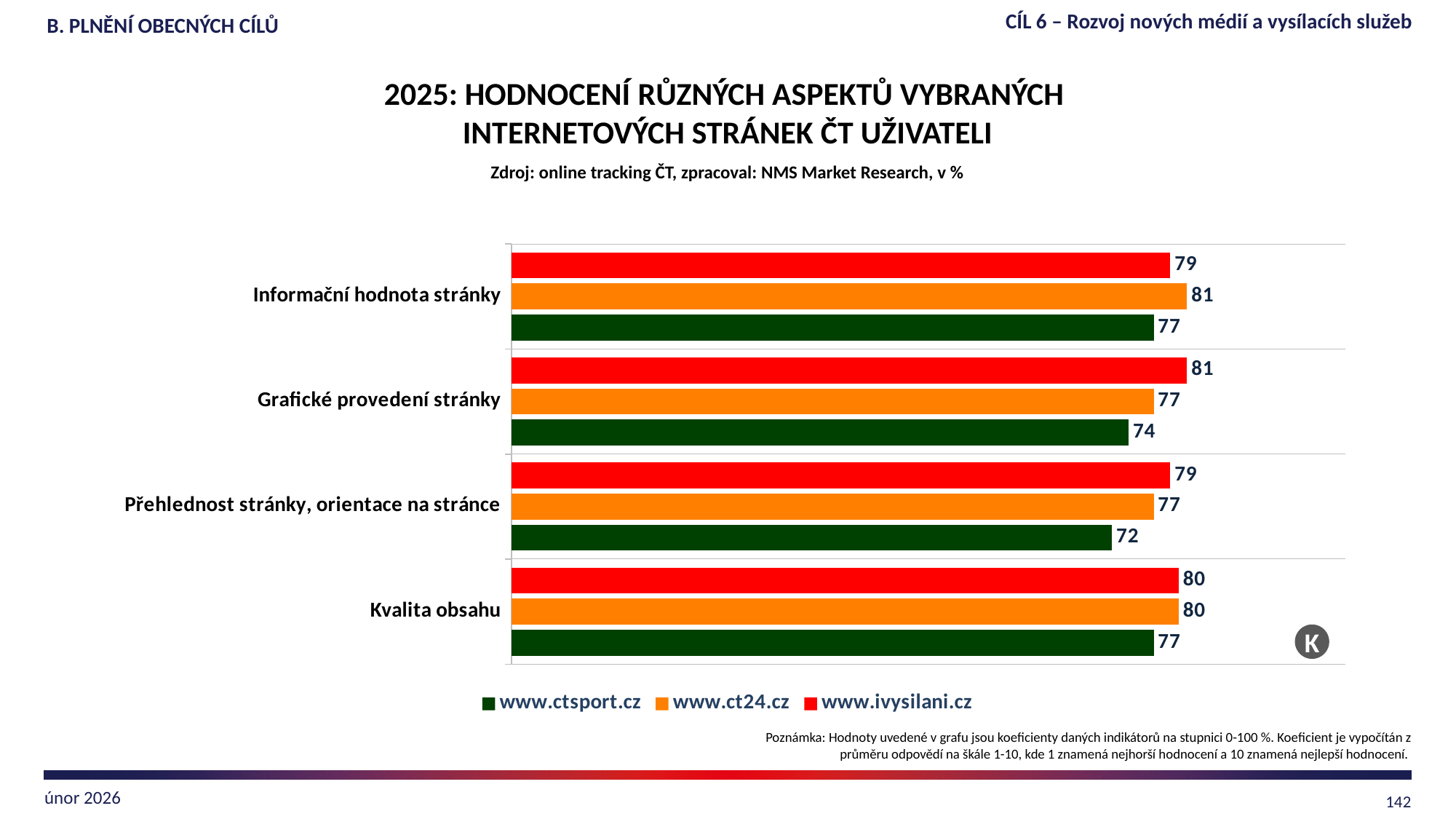
For which category does www.ivysilani.cz have its highest value? Grafické provedení stránky For which category does www.ctsport.cz have its lowest value? Přehlednost stránky, orientace na stránce How many series does the legend list? 3 What is the value for www.ivysilani.cz for Grafické provedení stránky? 81 For Informační hodnota stránky, which is larger: the value for www.ct24.cz or for www.ivysilani.cz? www.ct24.cz What is the value for www.ct24.cz for Kvalita obsahu? 80 Which website is shown in green in the legend? www.ctsport.cz What is the difference between the www.ivysilani.cz and www.ctsport.cz values for Grafické provedení stránky? 7 What is the value for www.ct24.cz for Informační hodnota stránky? 81 What is the value for www.ctsport.cz for Přehlednost stránky, orientace na stránce? 72 How many categories (aspects) are shown on the chart? 4 What kind of chart is shown on the slide? bar chart